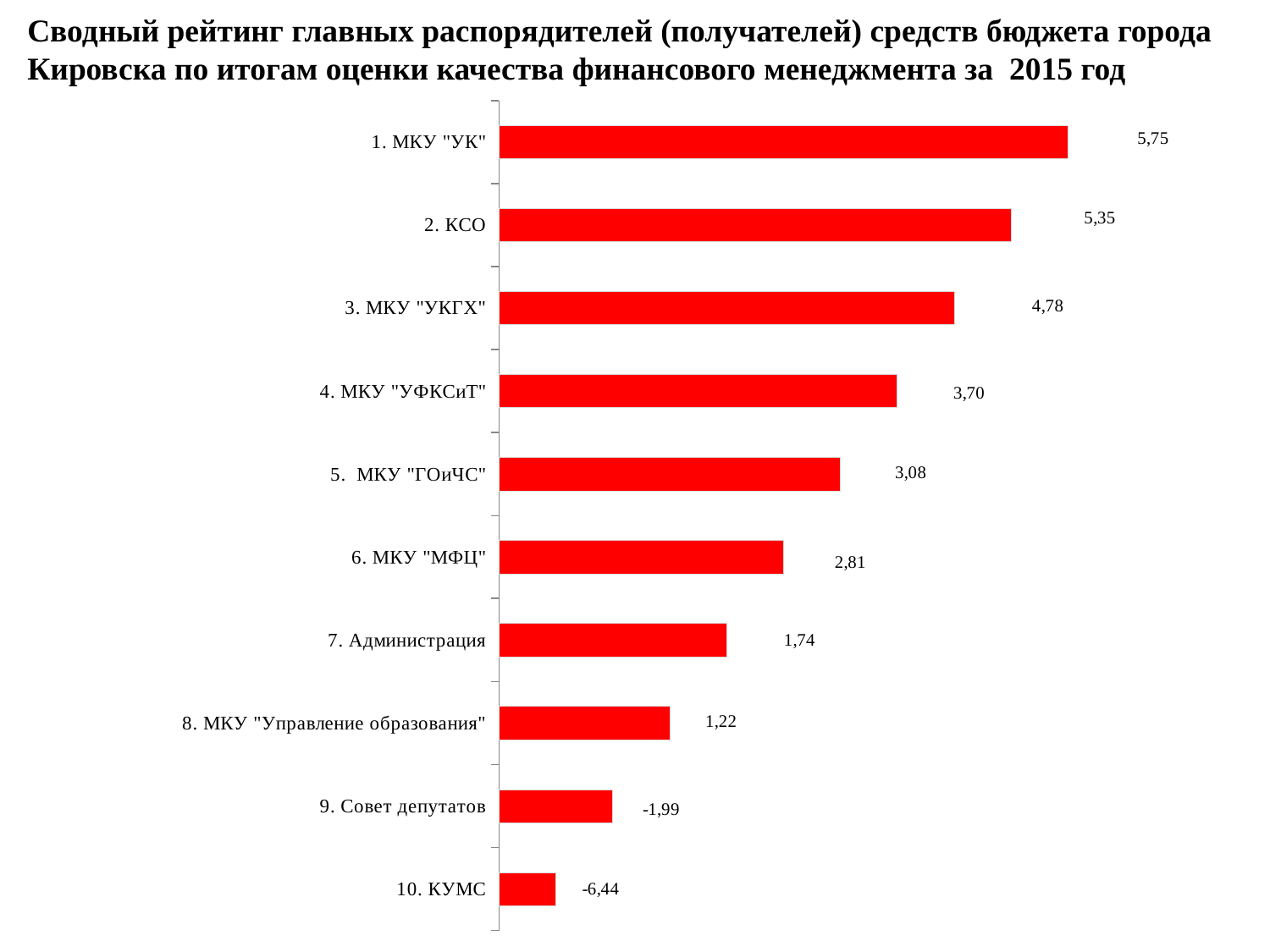
What is the value for 1. МКУ "УК"? 5,75 Which category has the highest value? 1. МКУ "УК" What kind of chart is shown on the slide? Bar chart What is the value for 8. МКУ "Управление образования"? 1,22 What is the value for 10. КУМС? -6,44 Which has a larger value, 6. МКУ "МФЦ" or 7. Администрация? 6. МКУ "МФЦ" Which category has the lowest value according to the data labels? 10. КУМС What is the difference between the values for 3. МКУ "УКГХ" and 4. МКУ "УФКСиТ"? 1,08 What is the difference between the values for 1. МКУ "УК" and 2. КСО? 0,40 What colour are the bars in the chart? Red What is the value for 5. МКУ "ГОиЧС"? 3,08 How many categories are shown in the chart? 10